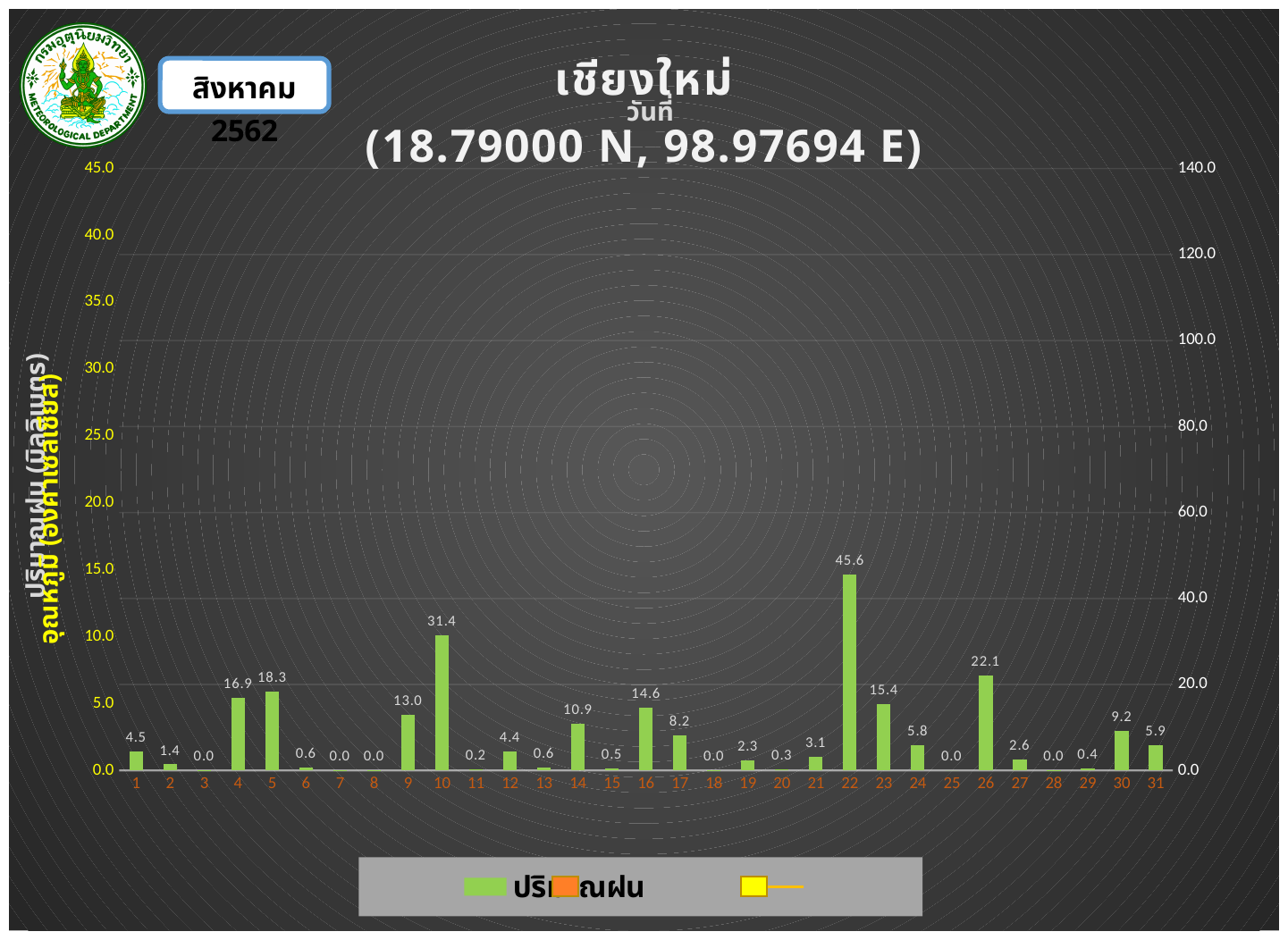
Which has a larger rainfall value, day 23 or day 30? day 23 What is the rainfall value for day 26? 22.1 What colour are the rainfall bars in the chart? green What kind of chart is shown on the slide? bar chart What is the difference between the rainfall values for day 5 and day 4? 1.4 Which day has the highest rainfall value? 22 What is the rainfall value for day 14? 10.9 What is the difference between the rainfall values for day 22 and day 10? 14.2 How many days are shown on the x axis? 31 What is the rainfall value for day 22? 45.6 Which has a larger rainfall value, day 16 or day 17? day 16 What is the rainfall value for day 10? 31.4